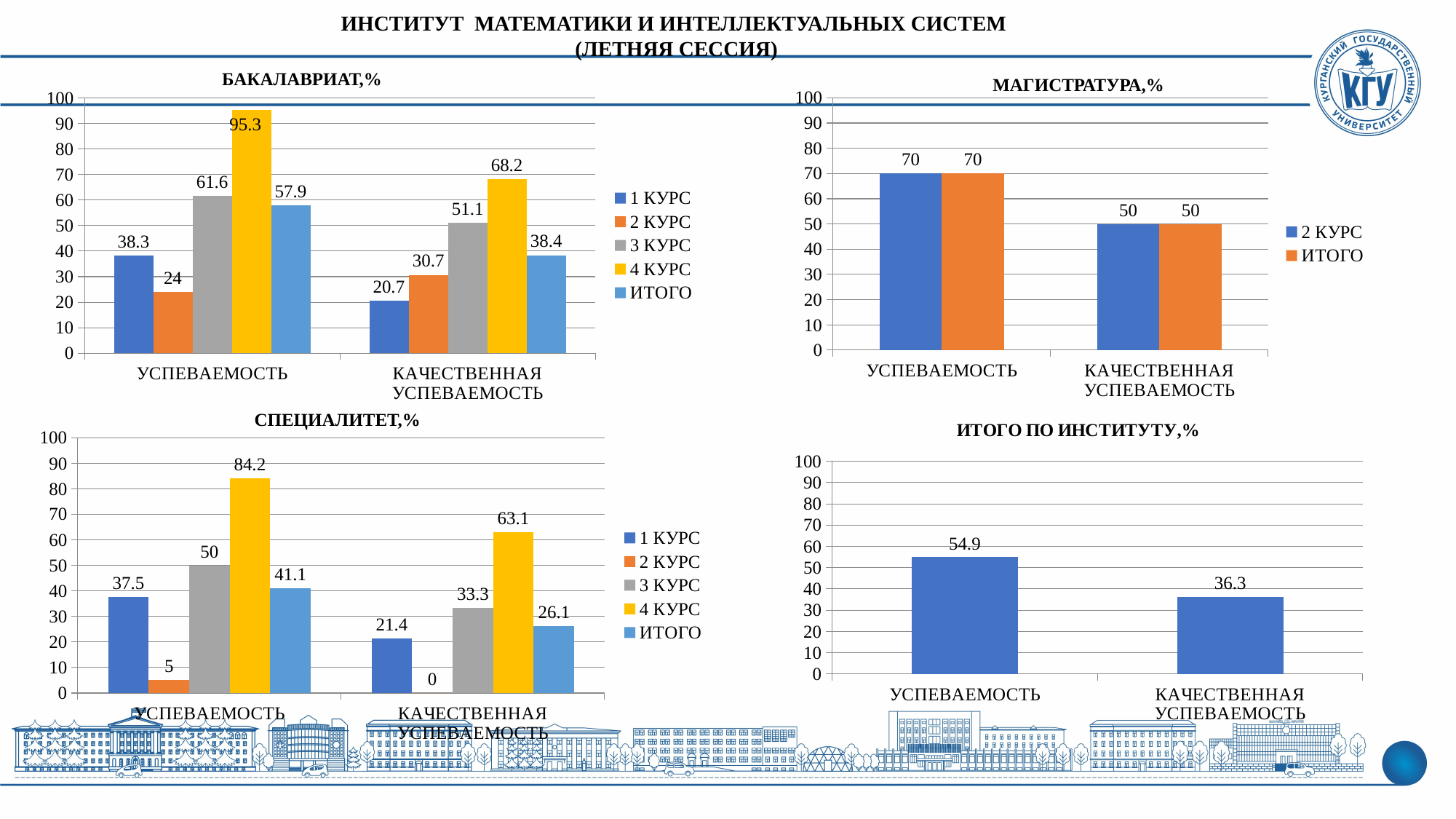
In the МАГИСТРАТУРА,% chart, what is the value for 2 КУРС under КАЧЕСТВЕННАЯ УСПЕВАЕМОСТЬ? 50 In the СПЕЦИАЛИТЕТ,% chart, what is the value for 2 КУРС under КАЧЕСТВЕННАЯ УСПЕВАЕМОСТЬ? 0 How many series does the legend of the БАКАЛАВРИАТ,% chart list? 5 In the БАКАЛАВРИАТ,% chart, what is the value for 4 КУРС under УСПЕВАЕМОСТЬ? 95.3 In the ИТОГО ПО ИНСТИТУТУ,% chart, what is the value for УСПЕВАЕМОСТЬ? 54.9 In the БАКАЛАВРИАТ,% chart, which series has the lowest value under КАЧЕСТВЕННАЯ УСПЕВАЕМОСТЬ? 1 КУРС In the МАГИСТРАТУРА,% chart, which category has the higher value for ИТОГО: УСПЕВАЕМОСТЬ or КАЧЕСТВЕННАЯ УСПЕВАЕМОСТЬ? УСПЕВАЕМОСТЬ In the СПЕЦИАЛИТЕТ,% chart, which series has the highest value under КАЧЕСТВЕННАЯ УСПЕВАЕМОСТЬ? 4 КУРС In the ИТОГО ПО ИНСТИТУТУ,% chart, what is the difference between УСПЕВАЕМОСТЬ and КАЧЕСТВЕННАЯ УСПЕВАЕМОСТЬ? 18.6 In the БАКАЛАВРИАТ,% chart, what is the difference between the ИТОГО values for УСПЕВАЕМОСТЬ and КАЧЕСТВЕННАЯ УСПЕВАЕМОСТЬ? 19.5 In the СПЕЦИАЛИТЕТ,% chart, what is the value for 2 КУРС under УСПЕВАЕМОСТЬ? 5 What type of chart is the ИТОГО ПО ИНСТИТУТУ,% chart? Bar chart